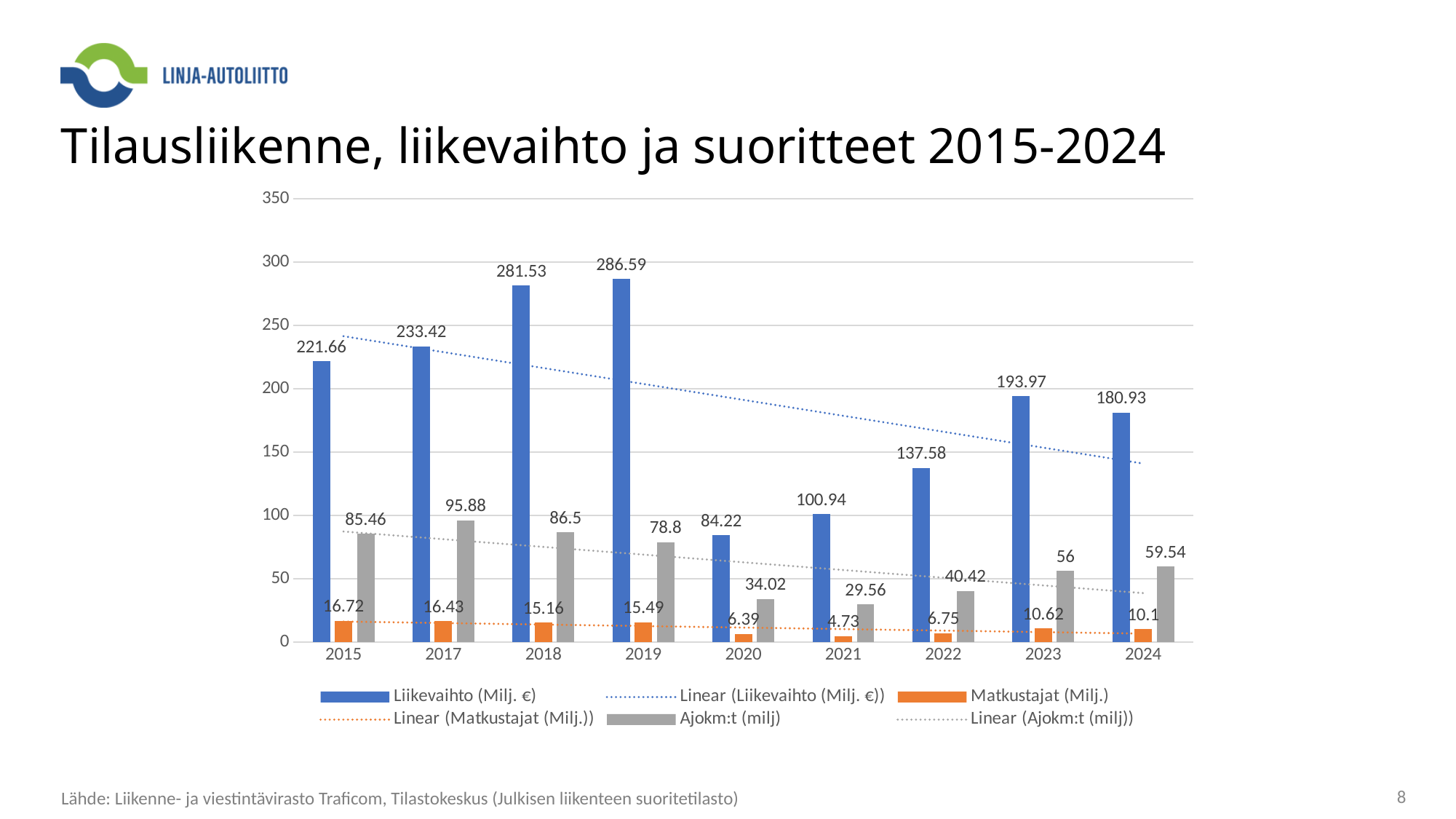
Which year has the lowest Ajokm:t (milj) value? 2021 Which is larger, the Ajokm:t (milj) value for 2015 or for 2018? 2018 How many entries does the legend list? 6 Which year has the highest Liikevaihto (Milj. €) value? 2019 How many years are shown on the x axis? 9 What colour are the Matkustajat (Milj.) bars? orange Is the Liikevaihto (Milj. €) value for 2022 greater or less than 150? less What is the Liikevaihto (Milj. €) value for 2019? 286.59 What kind of chart is shown on the slide? bar chart What is the Ajokm:t (milj) value for 2017? 95.88 What is the difference between the Liikevaihto (Milj. €) values for 2023 and 2024? 13.04 What is the Matkustajat (Milj.) value for 2021? 4.73